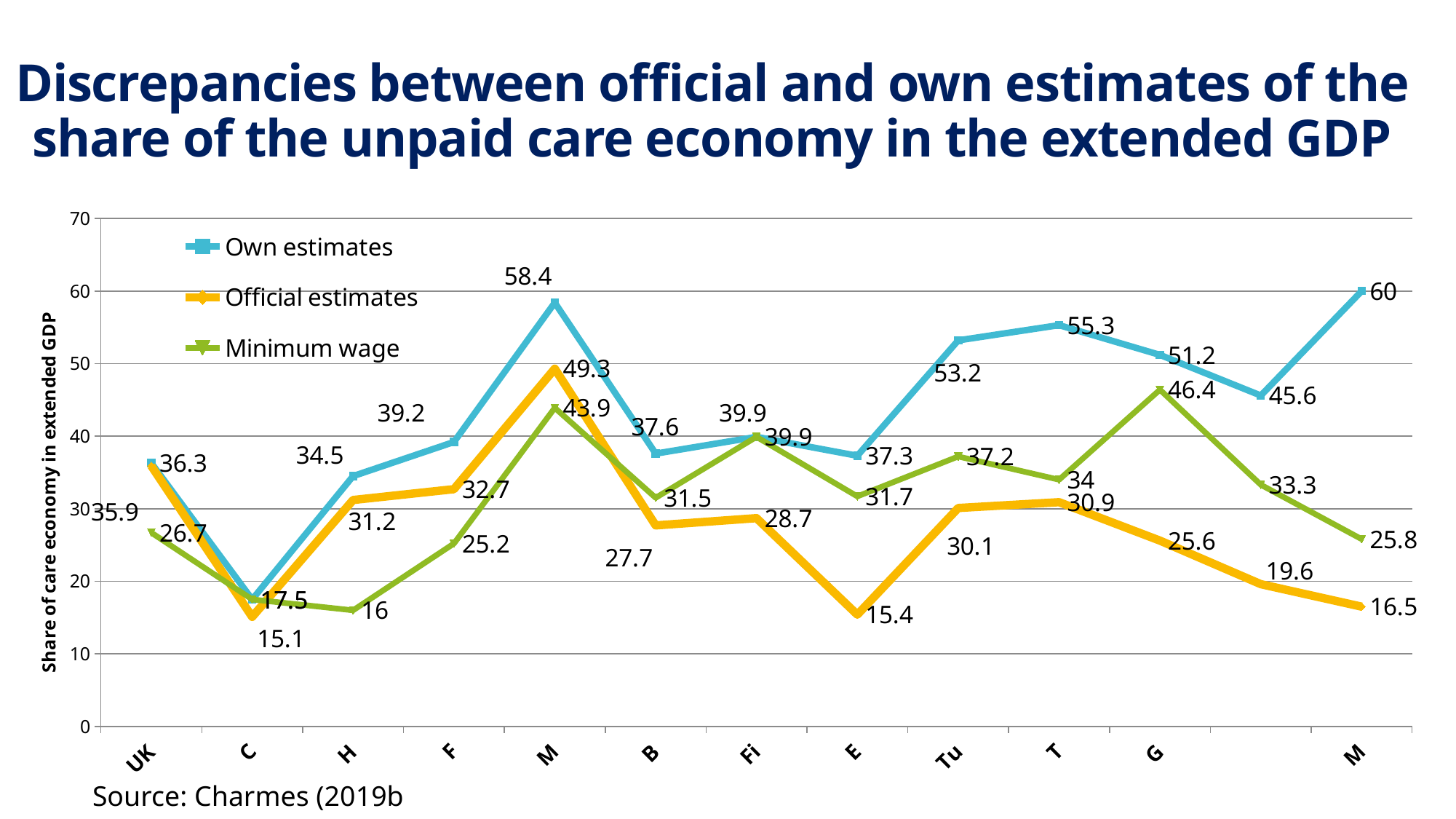
For B, which is larger: the Own estimates value or the Minimum wage value? Own estimates How many series does the legend list? 3 What is the Official estimates value for E? 15.4 Which category has the lowest Official estimates value? C What is the Own estimates value for T? 55.3 What is the difference between the Own estimates and Official estimates values for Tu? 23.1 What kind of chart is shown on the slide? line chart What is the Official estimates value for UK? 35.9 Between T and the final category M, do the Official estimates values rise or fall? fall What is the Minimum wage value for G? 46.4 Is the Own estimates value for H greater or less than 30? greater Which category has the highest Minimum wage value? G